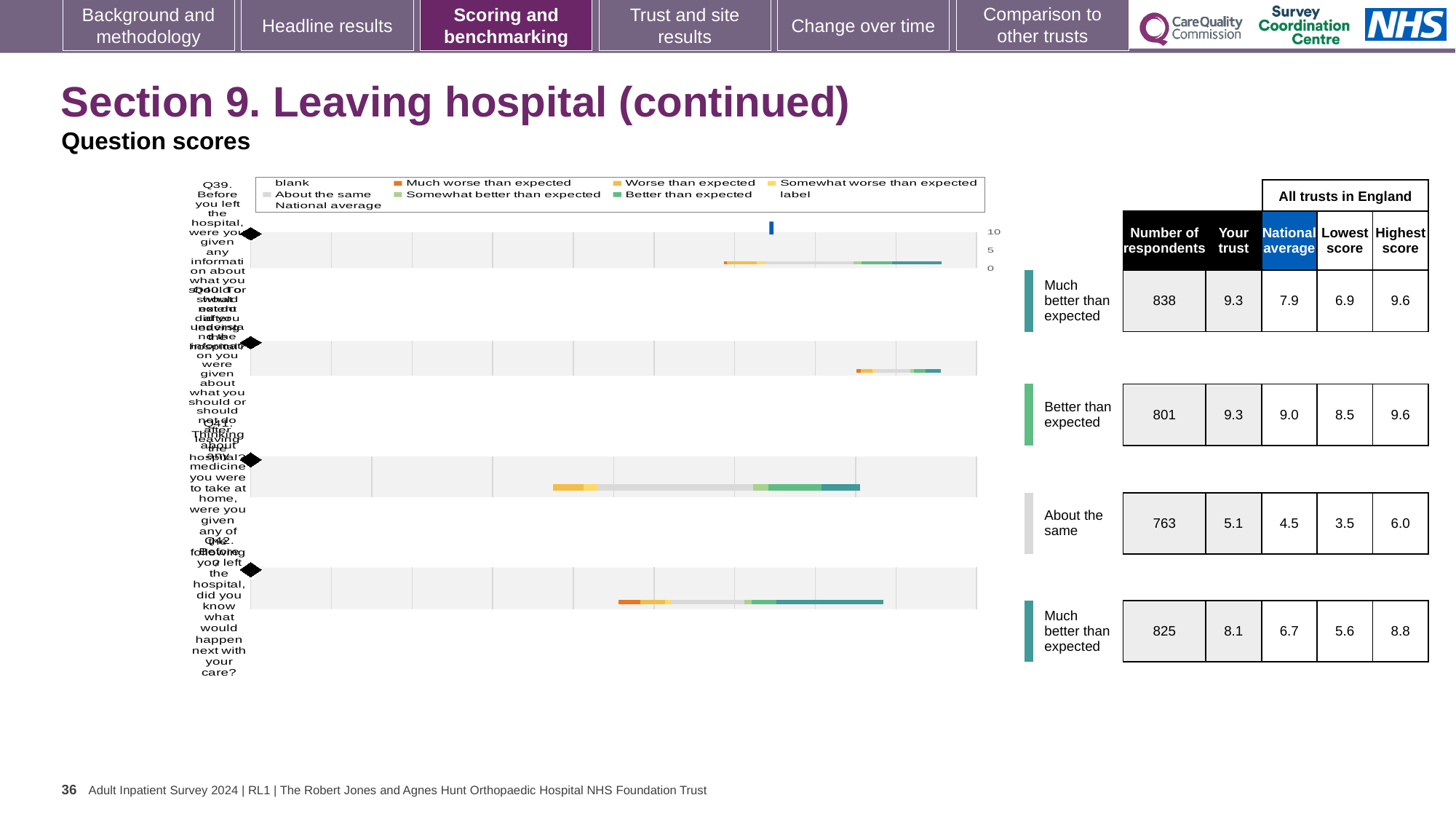
What kind of chart is shown on the left of the slide? bar chart How many question bars are plotted in the chart? 4 In the table, what is the difference between the highest score and the lowest score in the 'About the same' row? 2.5 What colour does the legend use for 'Much worse than expected'? orange How many rows of scores does the table contain? 4 What colour does the legend use for 'Better than expected'? green In the table, what is the 'Your trust' score in the second row (Better than expected)? 9.3 In the table, what is the national average in the bottom row? 6.7 In the table, which row has the lowest 'Your trust' score? About the same (5.1) In the table, what is the lowest score in the 'Better than expected' row? 8.5 In the table, what is the number of respondents in the top row (Much better than expected)? 838 In the bottom row of the table, which is larger: the 'Your trust' score or the national average? Your trust